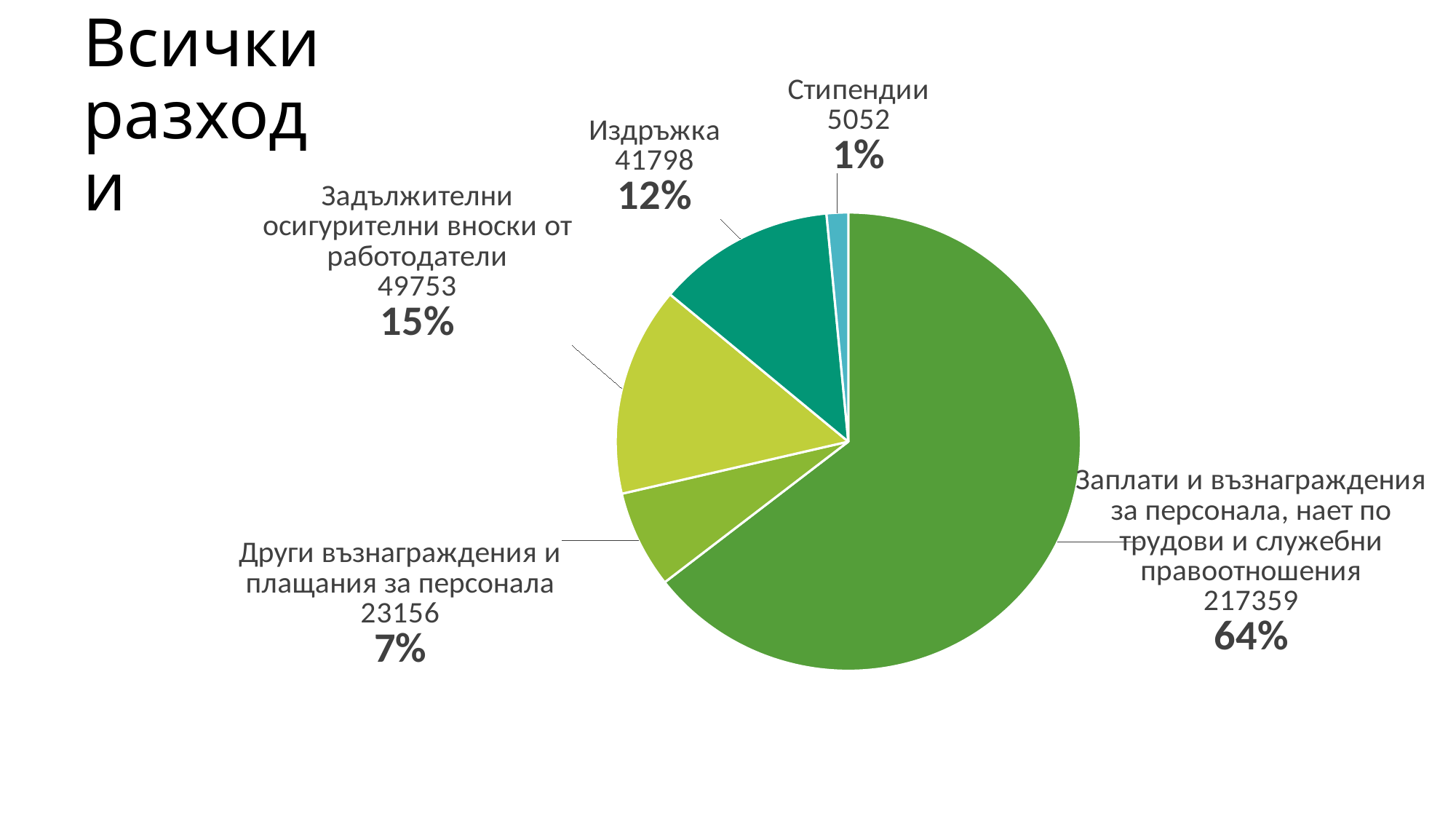
What is the title of the chart? Всички разходи Which category has the smallest slice? Стипендии What is the difference between the values for Задължителни осигурителни вноски от работодатели and Издръжка? 7955 What is the value for Задължителни осигурителни вноски от работодатели? 49753 What is the value for Други възнаграждения и плащания за персонала? 23156 What share of the pie does Заплати и възнаграждения за персонала, нает по трудови и служебни правоотношения take? 64% What share of the pie does Издръжка take? 12% What is the value for Издръжка? 41798 What kind of chart is shown on the slide? Pie chart Which category has the largest slice? Заплати и възнаграждения за персонала, нает по трудови и служебни правоотношения How many slices does the pie chart have? 5 What is the value for Стипендии? 5052